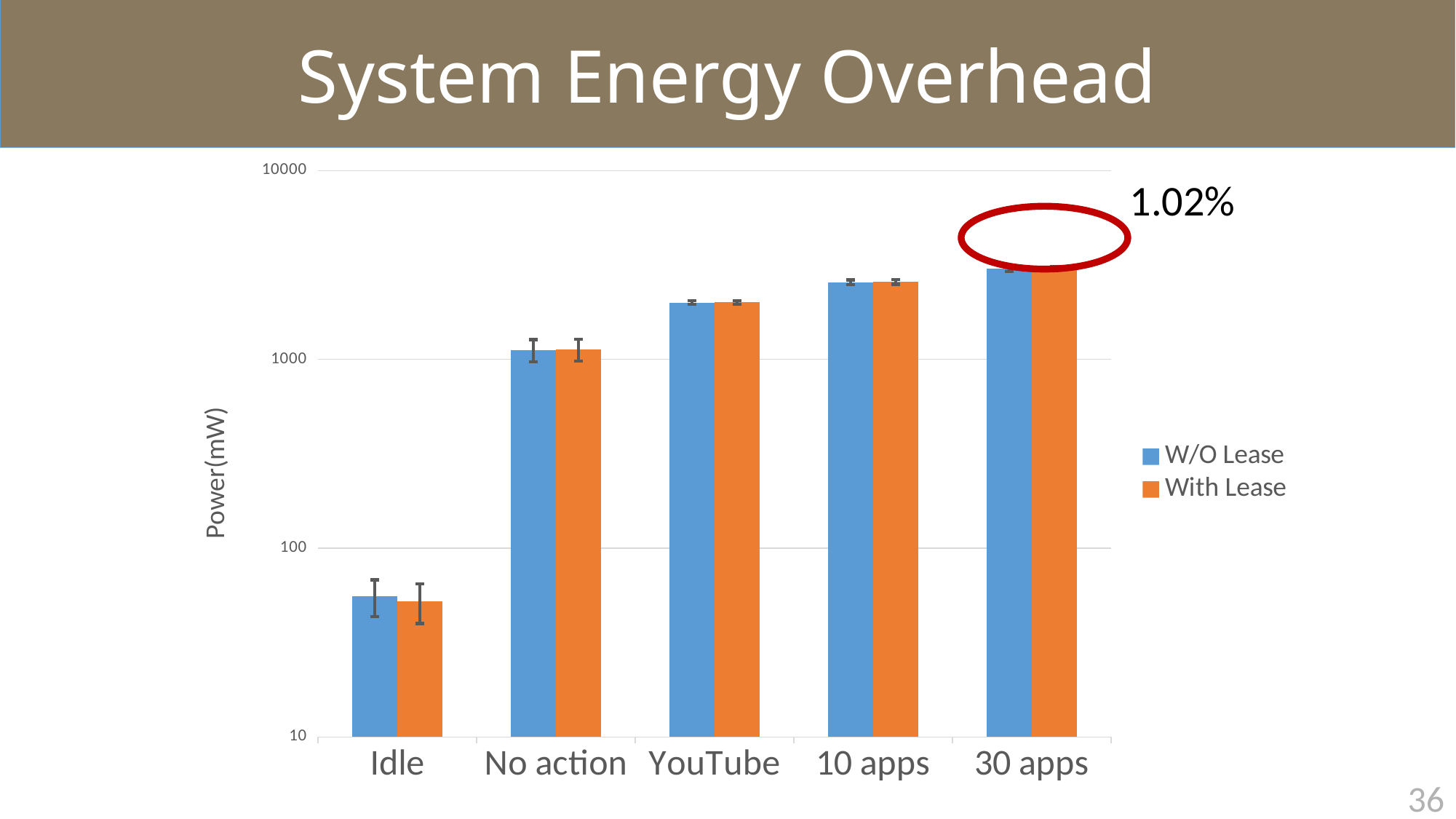
Which category has the lowest power values in the chart? Idle What is the label of the y axis of the chart? Power(mW) Which is larger, the W/O Lease value for YouTube or the W/O Lease value for Idle? YouTube Do the power values rise or fall moving from Idle to 30 apps along the x axis? rise How many categories are shown on the x axis of the chart? 5 Which category has the highest power values in the chart? 30 apps What kind of chart is shown on the slide? bar chart Is the W/O Lease value for 30 apps greater or less than 10000? less Is the With Lease value for YouTube greater or less than 1000? greater Is the With Lease value for 10 apps greater or less than 1000? greater How many series does the chart's legend list? 2